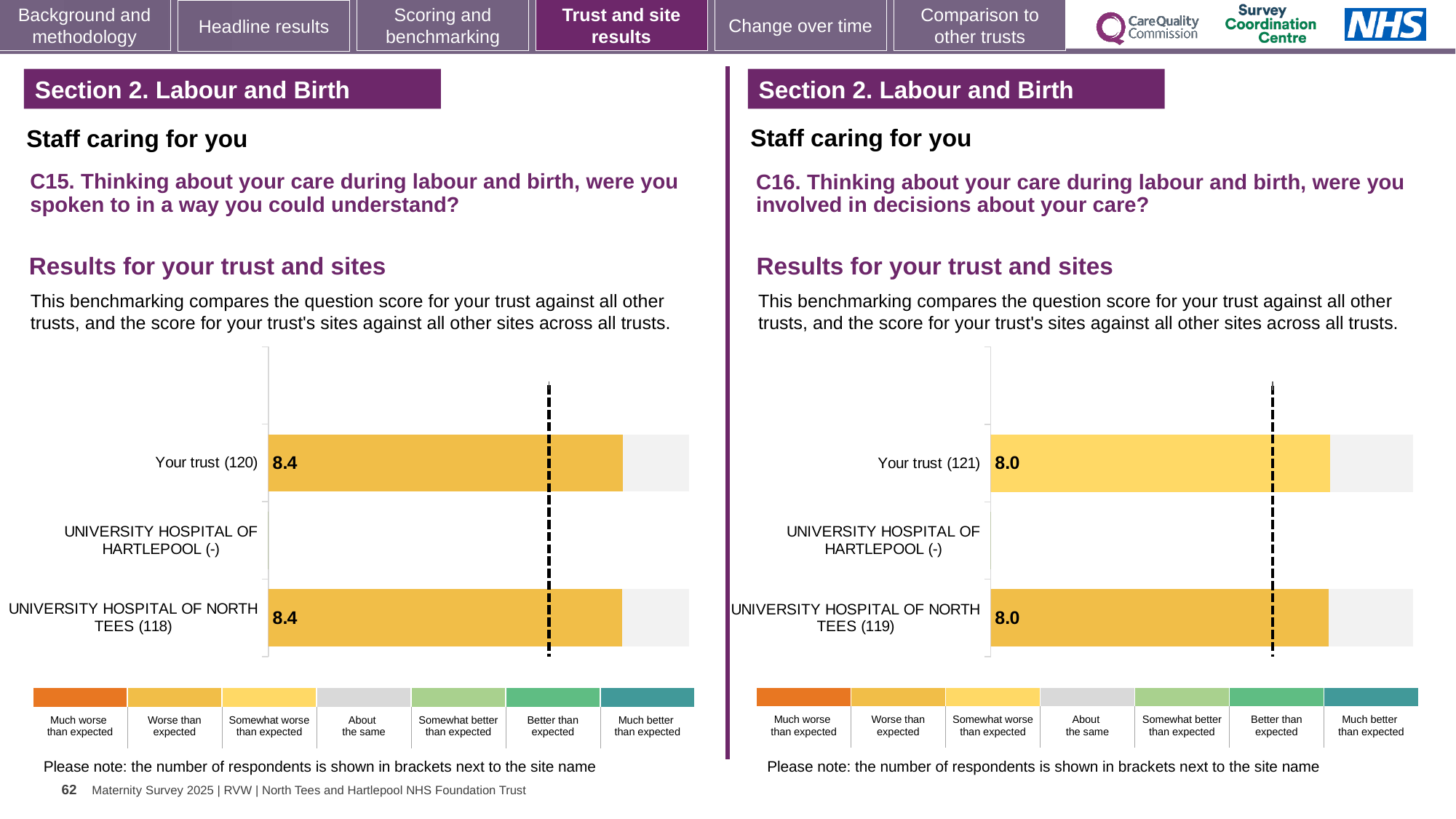
On the C15 chart (left), how many respondents are shown in brackets for Your trust? 120 On the C16 chart (right), which site has no bar plotted? University Hospital of Hartlepool On the C15 chart (left), what is the difference between the score for Your trust and the score for University Hospital of North Tees? 0.0 On the C16 chart (right), what is the score for Your trust? 8.0 On the C16 chart (right), what is the score for University Hospital of North Tees? 8.0 On the C16 chart (right), how many respondents are shown in brackets for University Hospital of North Tees? 119 Is the score for Your trust on the C15 chart (left) larger or smaller than the score for Your trust on the C16 chart (right)? Larger On the C16 chart (right), how many categories are listed on the vertical axis? 3 On the C15 chart (left), what is the score for University Hospital of North Tees? 8.4 On the C15 chart (left), what is the score for Your trust? 8.4 What kind of chart is the C15 chart on the left? Bar chart